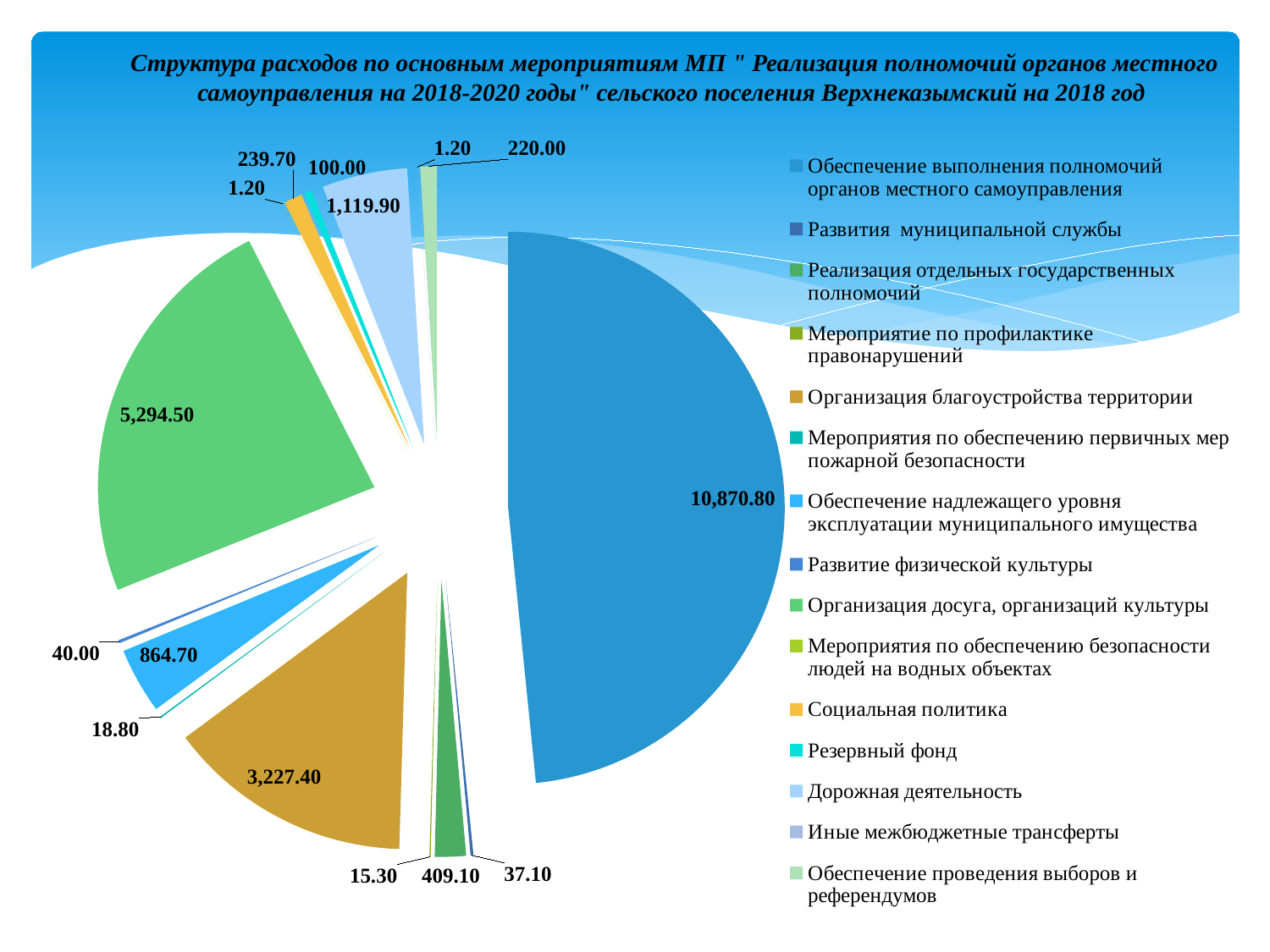
What is the value shown for Организация досуга, организаций культуры? 5,294.50 What is the value shown for Дорожная деятельность? 1,119.90 What kind of chart is shown on the slide? pie chart How many categories does the legend of the pie chart list? 15 What is the difference between the values for Организация досуга, организаций культуры and Организация благоустройства территории? 2,067.10 What is the value shown for Резервный фонд? 100.00 What is the value shown for the largest slice of the pie chart? 10,870.80 What is the value shown for Обеспечение проведения выборов и референдумов? 220.00 Which is larger: the value for Дорожная деятельность or the value for Обеспечение надлежащего уровня эксплуатации муниципального имущества? Дорожная деятельность Which category has the largest slice in the pie chart? Обеспечение выполнения полномочий органов местного самоуправления What is the value shown for Организация благоустройства территории? 3,227.40 Which year does the chart title say the expenditure structure is for? 2018